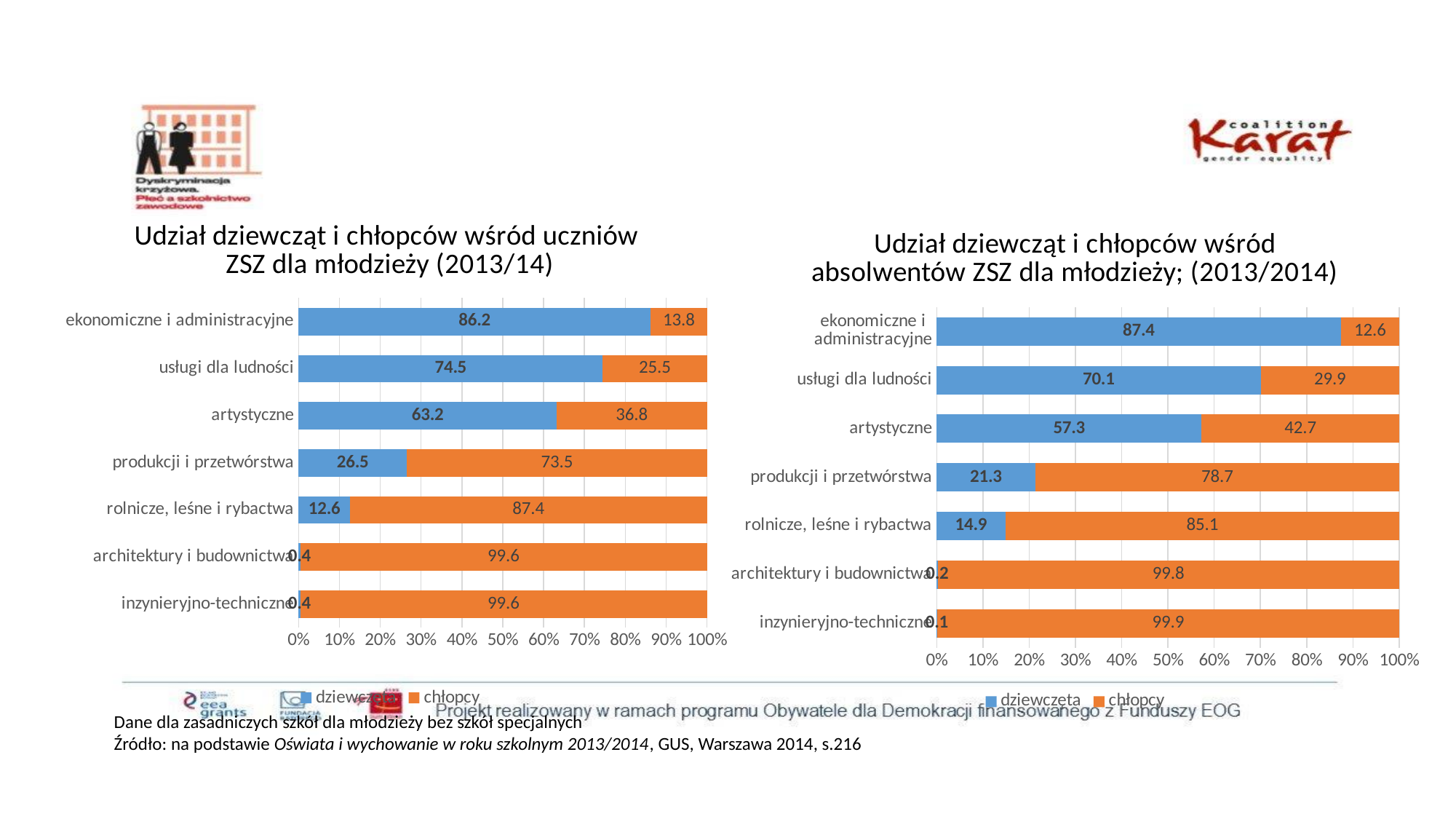
In the right chart (absolwentów ZSZ), what is the value for chłopcy in the category 'rolnicze, leśne i rybactwa'? 85.1 In the left chart (uczniów ZSZ), which category has the highest value for dziewczęta? ekonomiczne i administracyjne In the right chart (absolwentów ZSZ), which category has the lowest value for dziewczęta? inzynieryjno-techniczne How many categories are shown in the right chart (absolwentów ZSZ)? 7 What are the two legend entries in the right chart (absolwentów ZSZ)? dziewczęta, chłopcy How many series does the legend of the left chart (uczniów ZSZ) list? 2 In the right chart (absolwentów ZSZ), what is the value for dziewczęta in the category 'usługi dla ludności'? 70.1 In the left chart (uczniów ZSZ), what is the difference between the chłopcy and dziewczęta values for 'artystyczne'? 26.4 In the left chart (uczniów ZSZ), what is the value for dziewczęta in the category 'ekonomiczne i administracyjne'? 86.2 In the left chart (uczniów ZSZ), what is the value for chłopcy in the category 'produkcji i przetwórstwa'? 73.5 In the right chart (absolwentów ZSZ), which is larger for 'artystyczne': the dziewczęta value or the chłopcy value? dziewczęta What kind of chart is the left chart (uczniów ZSZ)? stacked bar chart